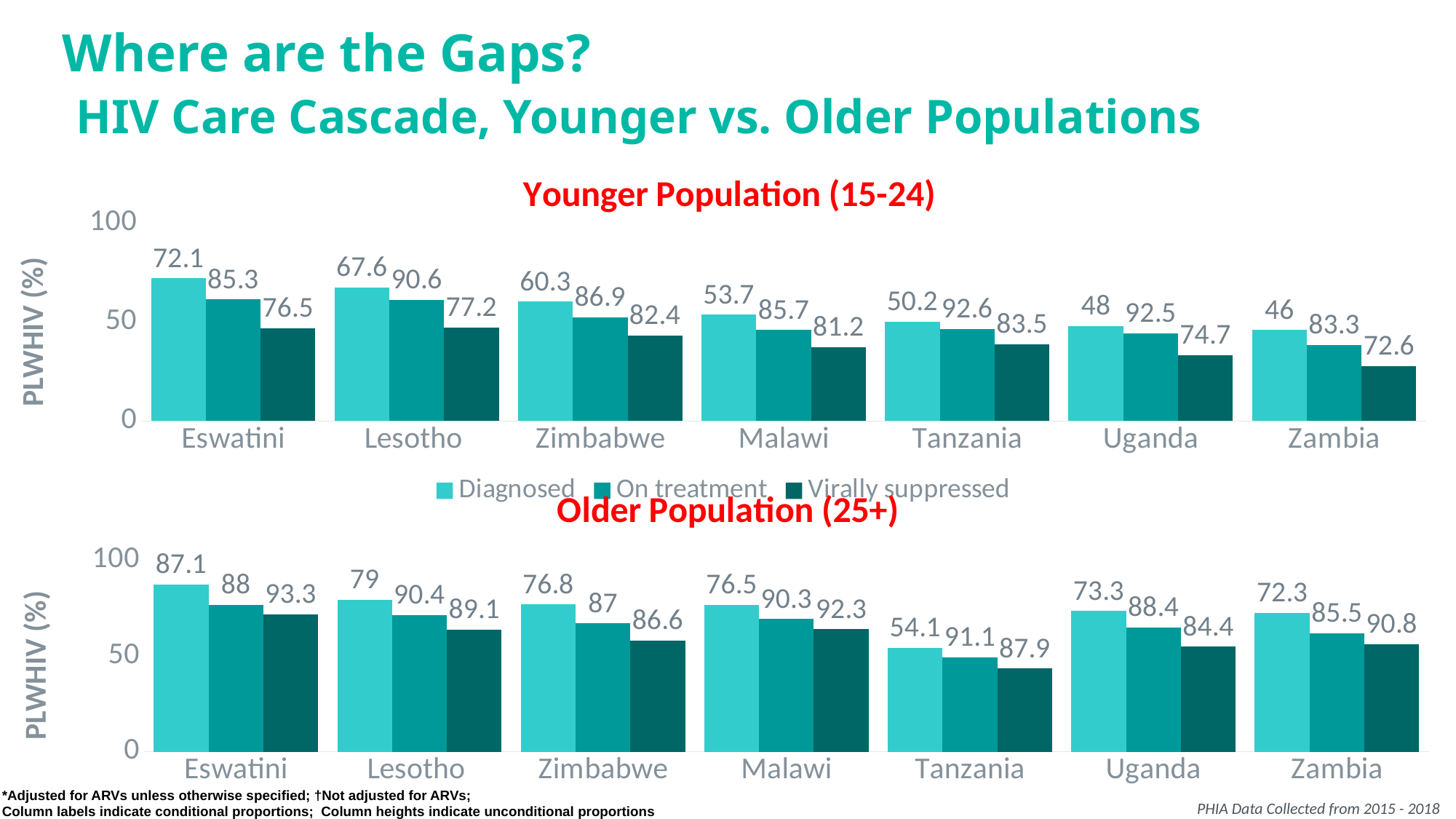
In the Younger Population (15-24) chart, which is larger: the Virally suppressed label for Zimbabwe or for Uganda? Zimbabwe In the Younger Population (15-24) chart, which country has the highest Diagnosed label? Eswatini In the Younger Population (15-24) chart, do the Diagnosed labels rise or fall from Eswatini to Zambia? fall In the Older Population (25+) chart, what is the Virally suppressed label for Malawi? 92.3 In the Younger Population (15-24) chart, what is the On treatment label for Tanzania? 92.6 In the Older Population (25+) chart, is the Diagnosed bar for Tanzania greater or less than 50? greater What kind of chart is the Older Population (25+) chart? bar chart How many countries are shown on the x axis of the Younger Population (15-24) chart? 7 In the Older Population (25+) chart, which country has the lowest Diagnosed label? Tanzania How many series does the legend list? 3 In the Younger Population (15-24) chart, what is the Diagnosed label for Eswatini? 72.1 What is the difference between the Diagnosed label for Eswatini in the Older Population (25+) chart and in the Younger Population (15-24) chart? 15